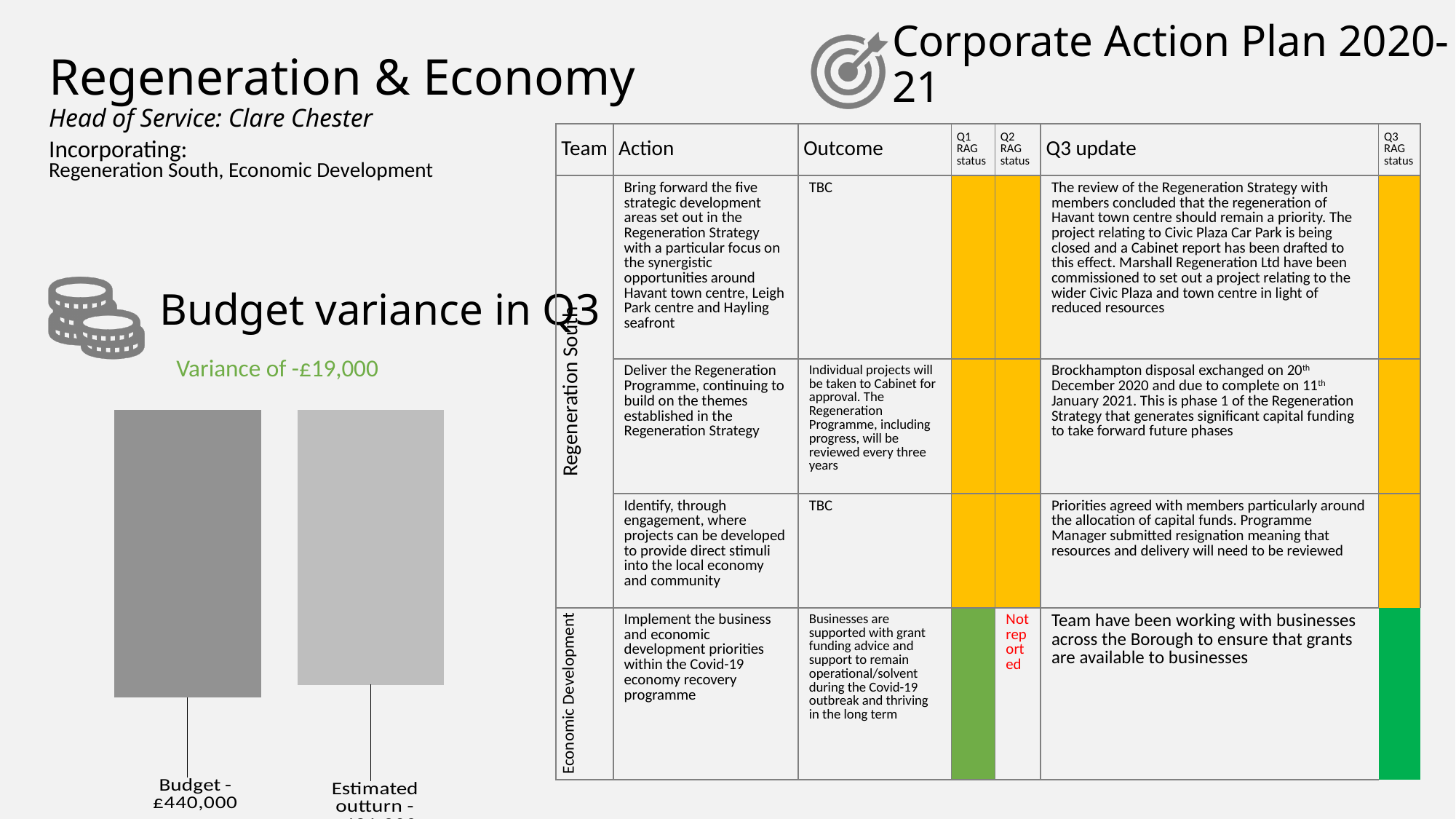
Which category has the lowest value in the 'Budget variance in Q3' chart? Estimated outturn What is the title shown above the bar chart on the left of the slide? Budget variance in Q3 In the 'Budget variance in Q3' chart, which bar is taller, Budget or Estimated outturn? Budget What kind of chart is shown under the heading 'Budget variance in Q3'? bar chart Which category has the highest value in the 'Budget variance in Q3' chart? Budget What is the value of the Budget bar in the 'Budget variance in Q3' chart? £440,000 How many bars does the 'Budget variance in Q3' chart show? 2 What variance is stated above the 'Budget variance in Q3' chart? Variance of -£19,000